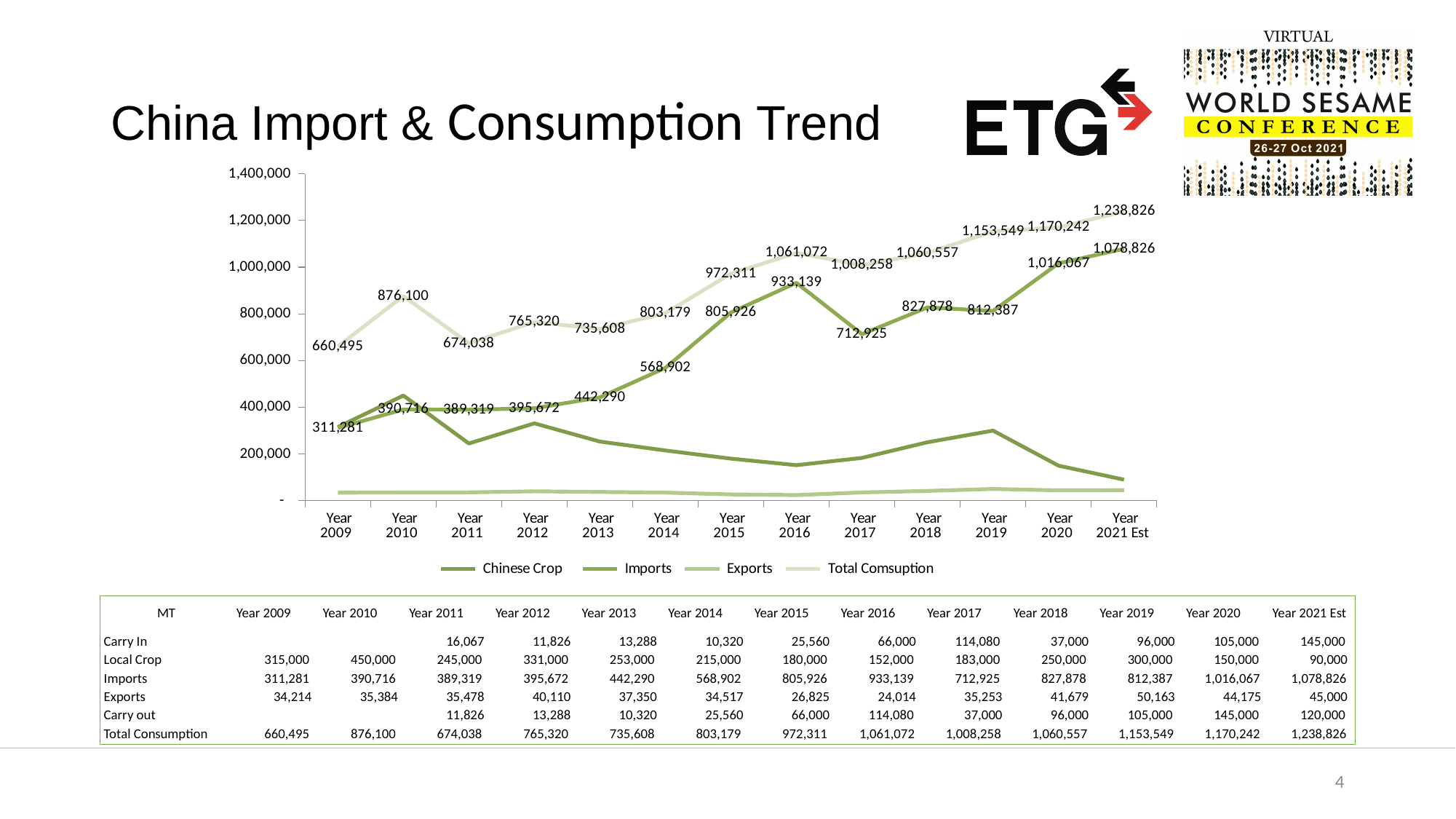
How many years are plotted along the x axis? 13 How many series does the chart legend list? 4 What is the Imports value for Year 2016? 933,139 What kind of chart is shown on the slide? line chart What is the difference between Imports in Year 2016 and Imports in Year 2015? 127,213 In which year is Total Consumption highest? Year 2021 Est In which year is the Imports value lowest? Year 2009 What is the Total Consumption value for Year 2010? 876,100 Which is larger: Imports in Year 2017 or Imports in Year 2018? Year 2018 What is the difference between Total Consumption and Imports in Year 2021 Est? 160,000 Is the Chinese Crop value for Year 2010 greater or less than 400,000? greater Do Imports rise or fall from Year 2009 to Year 2016? rise